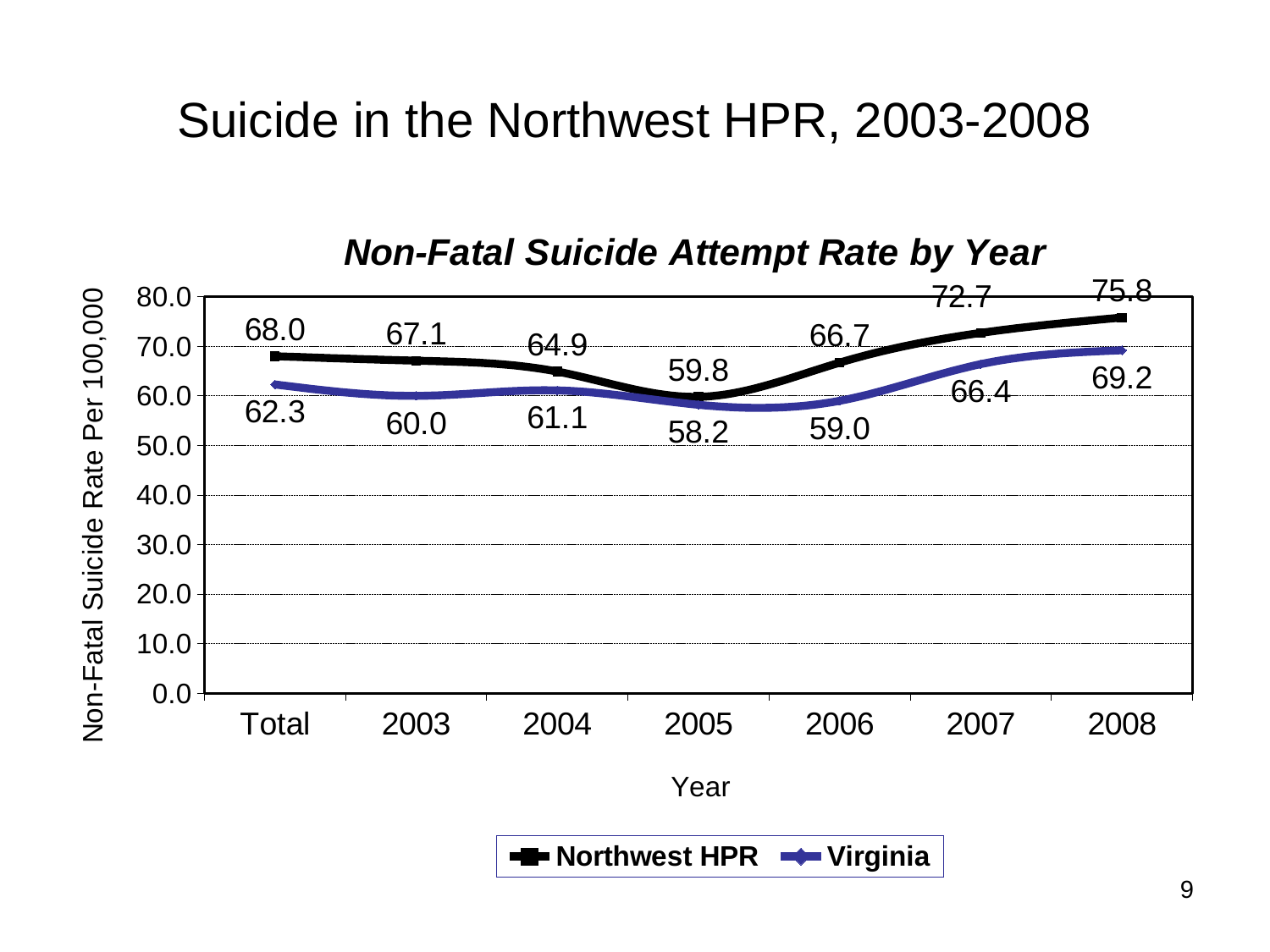
What type of chart is shown on the slide? line chart Which series has the higher rate in 2006, Northwest HPR or Virginia? Northwest HPR In which year is the Virginia rate highest? 2008 What is the Virginia non-fatal suicide attempt rate in 2005? 58.2 What is the difference between the Northwest HPR and Virginia rates in 2007? 6.3 What is the Northwest HPR value for the Total category? 68.0 Is the Virginia rate in 2004 greater or less than 70.0? less How many categories are shown on the x axis? 7 In which year is the Northwest HPR rate lowest? 2005 What is the Northwest HPR non-fatal suicide attempt rate in 2008? 75.8 What is the title of the chart? Non-Fatal Suicide Attempt Rate by Year How many series does the legend list? 2